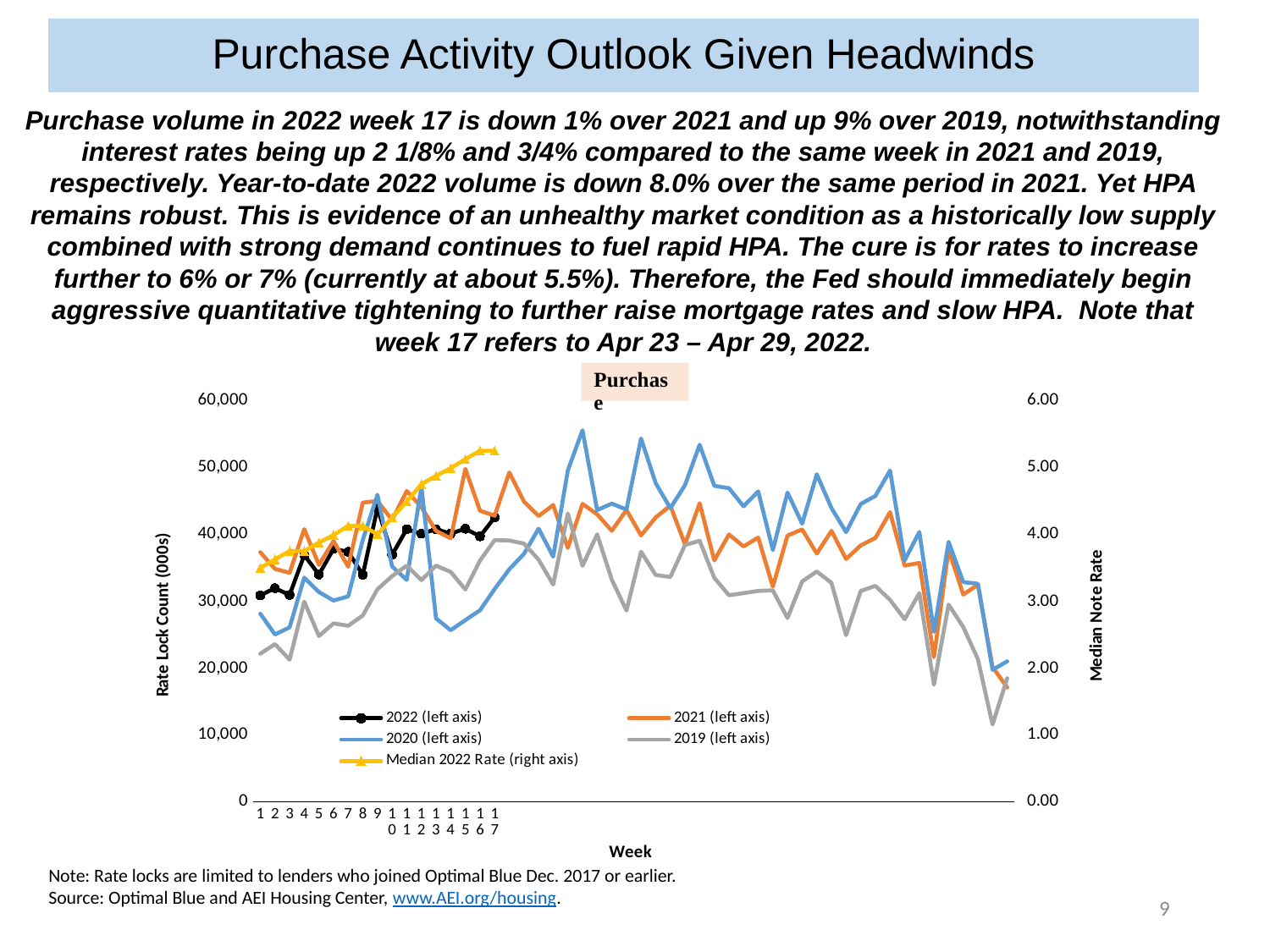
What kind of chart is shown on the slide? line chart Is the 2022 rate lock count at week 17 greater or less than 40,000? greater Is the highest point of the 2020 line greater or less than 50,000? greater Does the Median 2022 Rate line rise or fall from week 1 to week 17? rise How many series does the chart legend list? 5 Is the Median 2022 Rate at week 1 greater or less than 4.00? less Which series is plotted on the right axis according to the legend? Median 2022 Rate What is the title of the left vertical axis? Rate Lock Count (000s) At week 1, which is larger: the 2022 rate lock count or the 2019 rate lock count? 2022